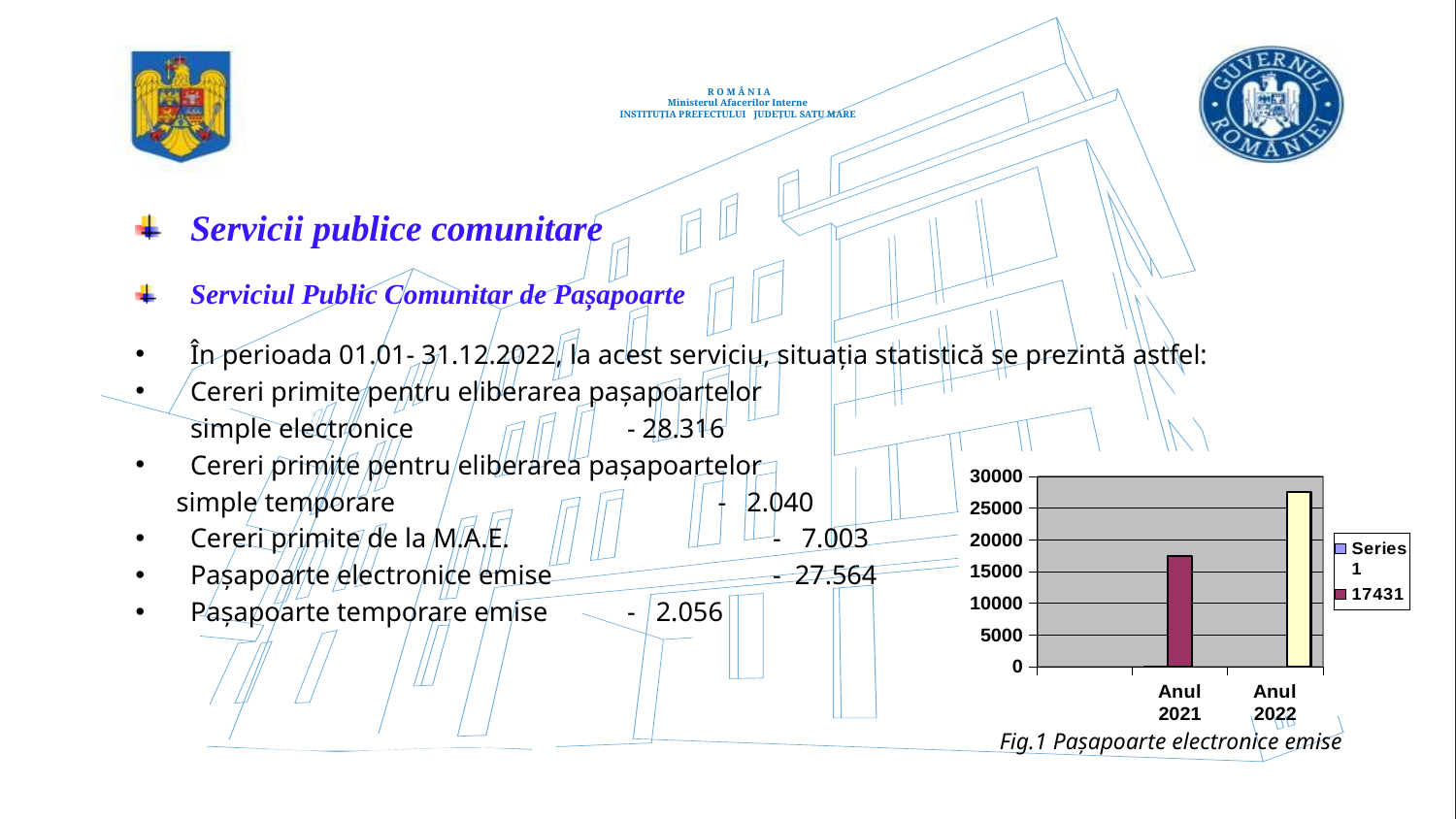
How many entries does the chart's legend list? 2 Which is larger in the chart, the bar for Anul 2021 or the bar for Anul 2022? Anul 2022 Is the bar for Anul 2022 greater or less than 25000? greater Do the bar values rise or fall from Anul 2021 to Anul 2022? rise Is the bar for Anul 2021 greater or less than 20000? less What is the caption of the chart on the slide? Fig.1 Pașapoarte electronice emise Is the bar for Anul 2021 greater or less than 15000? greater Which category has the lowest bar in the chart? Anul 2021 How many categories are shown on the x axis of the chart? 2 Which category has the highest bar in the chart? Anul 2022 What kind of chart is shown on the slide? bar chart